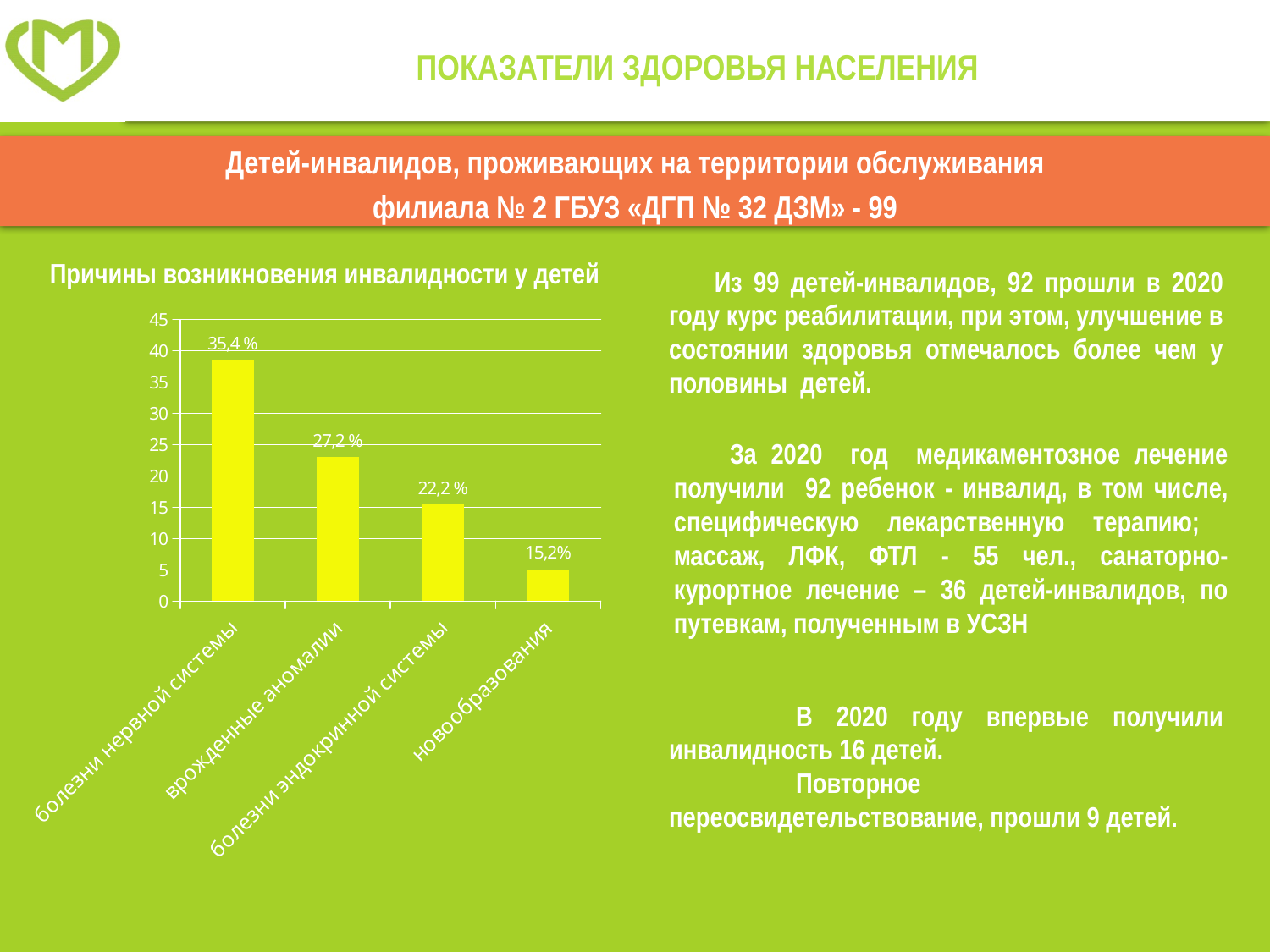
What type of chart is shown under the title «Причины возникновения инвалидности у детей»? bar chart What value is labelled for «новообразования» in the chart? 15,2% What is the title of the chart on the slide? Причины возникновения инвалидности у детей Which is larger in the chart: the value for «врожденные аномалии» or for «болезни эндокринной системы»? врожденные аномалии What colour are the bars in the chart «Причины возникновения инвалидности у детей»? yellow Which category has the lowest value in the chart «Причины возникновения инвалидности у детей»? новообразования Do the values in the chart rise or fall from left to right along the x axis? fall What value is labelled for «болезни эндокринной системы» in the chart? 22,2 % How many categories are shown in the chart «Причины возникновения инвалидности у детей»? 4 What value is labelled for «врожденные аномалии» in the chart? 27,2 % Which category has the highest value in the chart «Причины возникновения инвалидности у детей»? болезни нервной системы What value is labelled for «болезни нервной системы» in the chart? 35,4 %